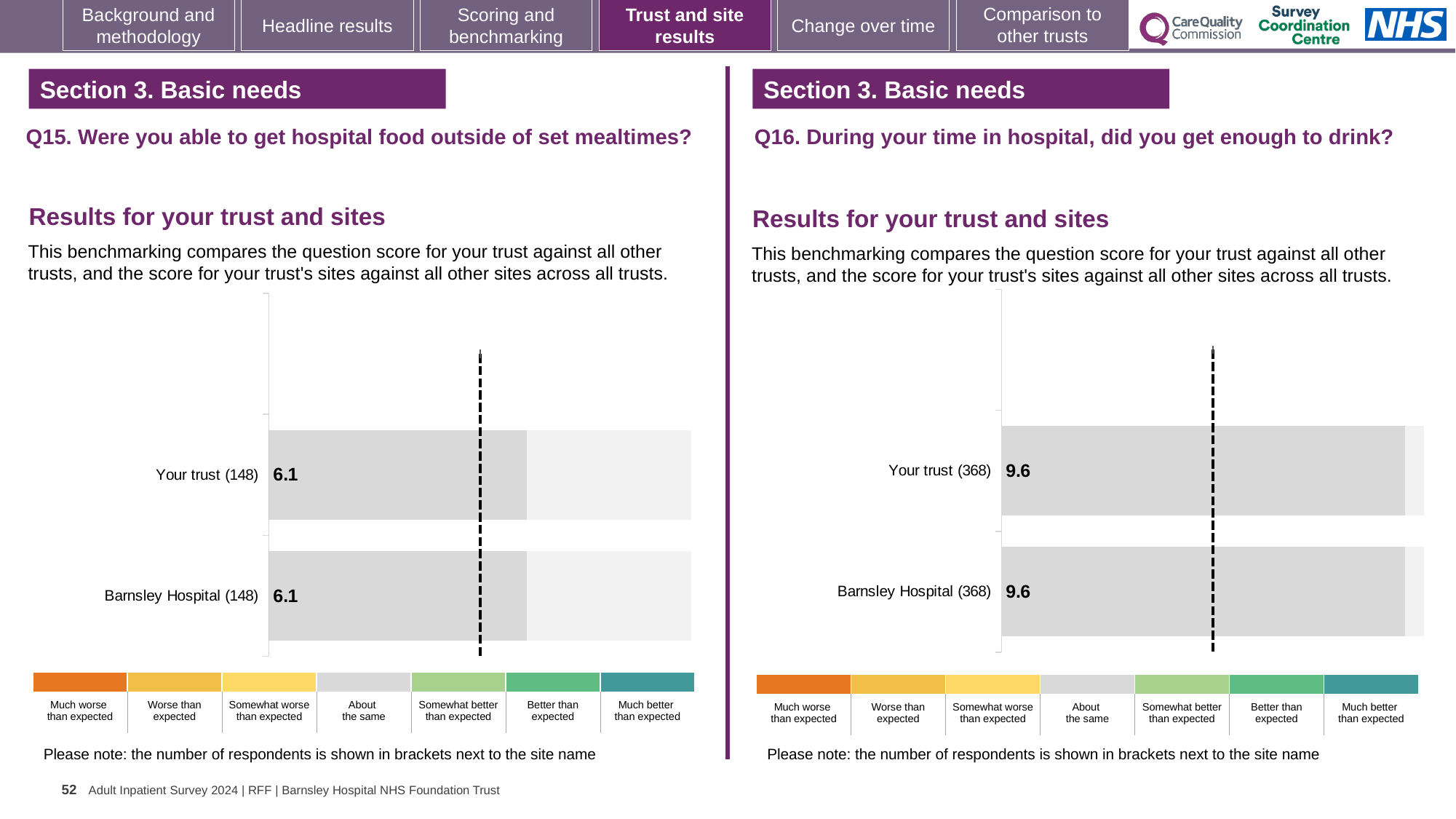
On the Q15 chart (left), what is the score for Your trust? 6.1 On the Q16 chart (right), what is the score for Barnsley Hospital? 9.6 What kind of chart is the Q15 chart (left)? Bar chart On the Q16 chart (right), how many bars are plotted? 2 On the Q15 chart (left), what is the difference between the score for Your trust and the score for Barnsley Hospital? 0.0 On the Q15 chart (left), how many bars are plotted? 2 On the Q15 chart (left), how many respondents are shown in brackets next to Your trust? 148 On the Q16 chart (right), how many respondents are shown in brackets next to Barnsley Hospital? 368 On the Q16 chart (right), what is the score for Your trust? 9.6 What kind of chart is the Q16 chart (right)? Bar chart On the Q16 chart (right), what is the difference between the score for Your trust and the score for Barnsley Hospital? 0.0 On the Q15 chart (left), what is the score for Barnsley Hospital? 6.1